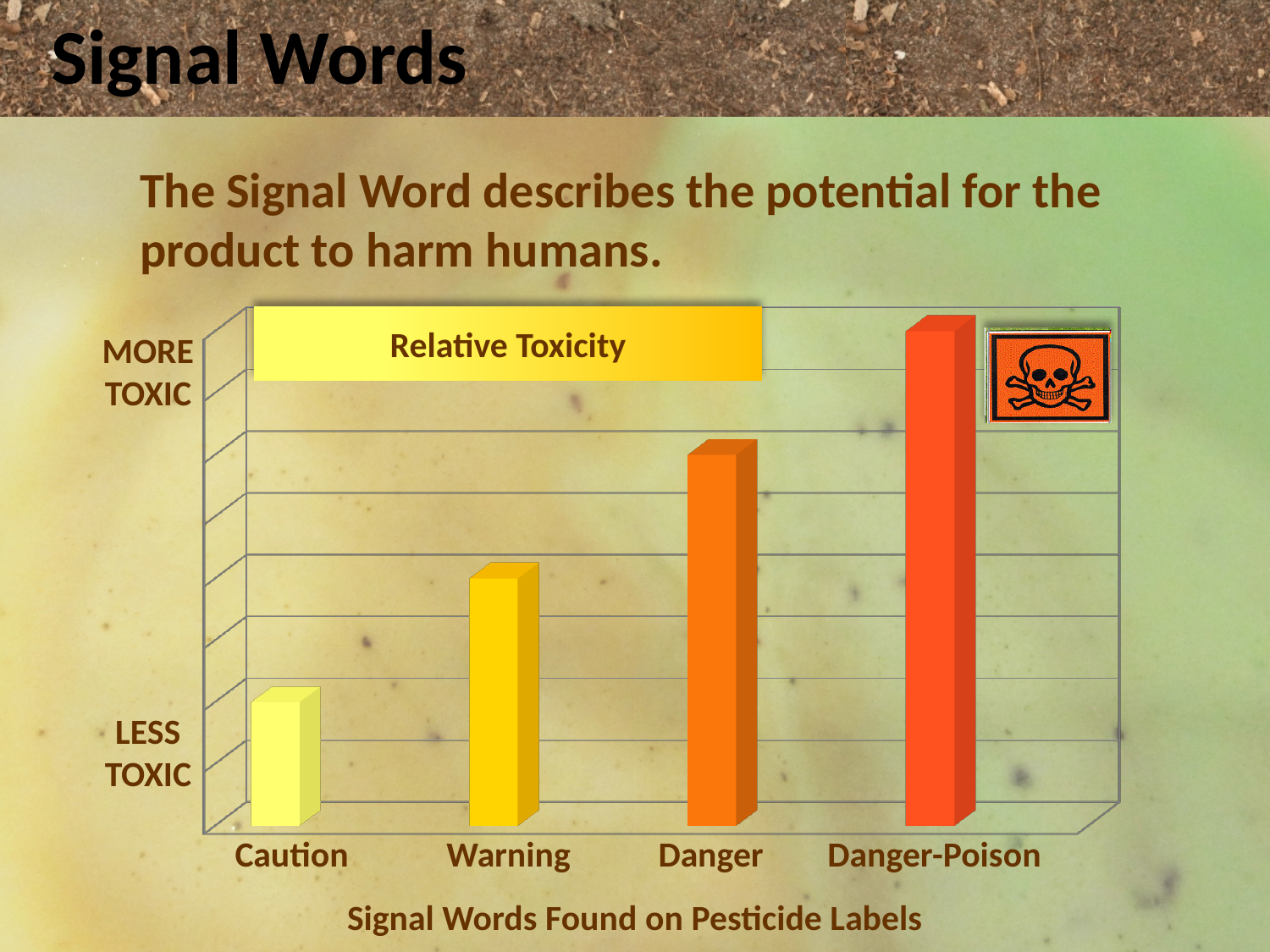
Which signal word has the shortest bar in the chart? Caution Which bar is taller, Warning or Danger? Danger What kind of chart is shown on the slide? bar chart How many signal word categories are plotted in the chart? 4 Which signal word has the tallest bar in the chart? Danger-Poison Do the bars rise or fall moving from Caution to Danger-Poison along the x axis? rise Which bar is taller, Caution or Warning? Warning What is the title shown in the box at the top of the chart? Relative Toxicity What caption appears below the chart's category labels? Signal Words Found on Pesticide Labels